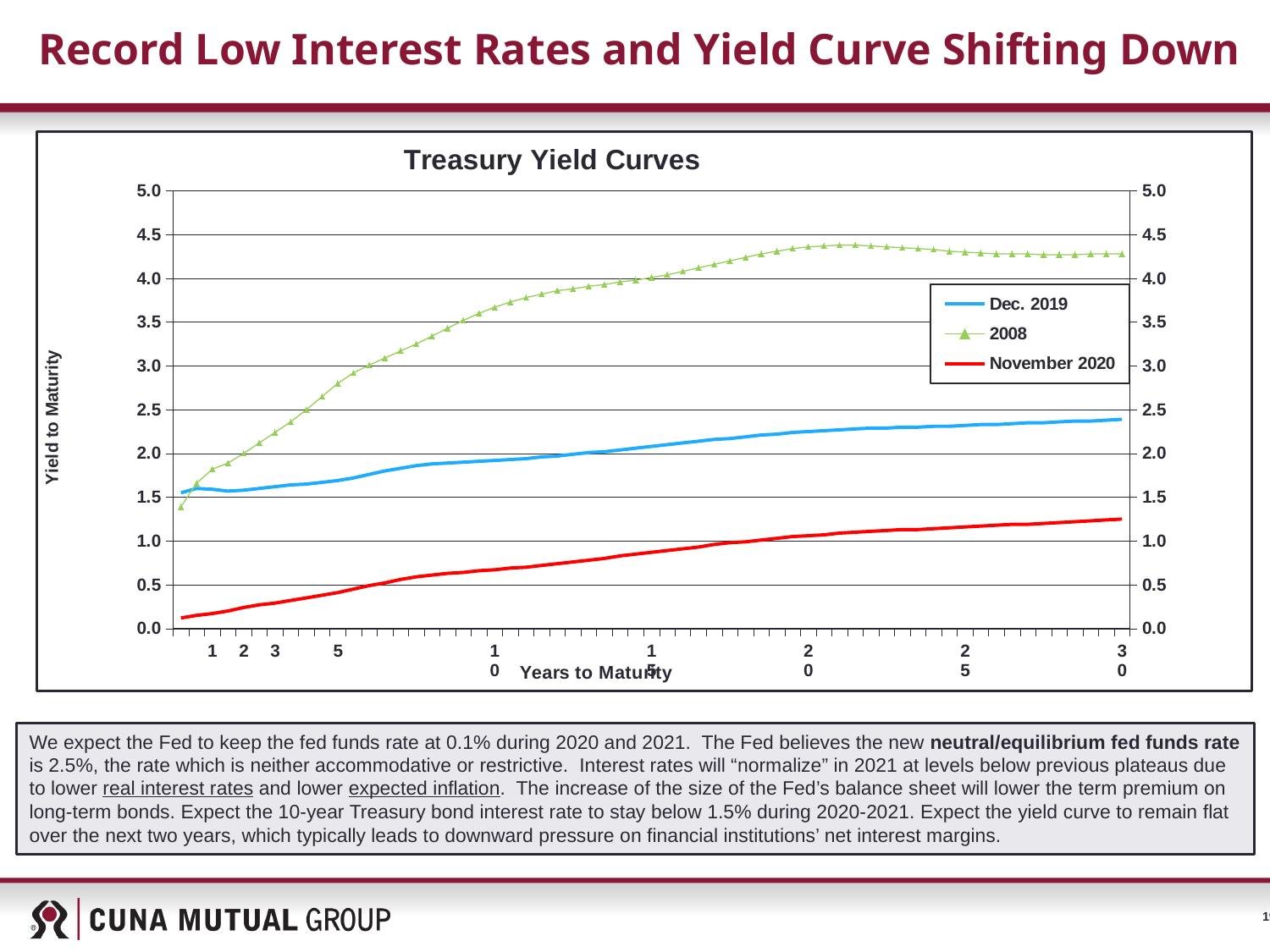
Which series has the lowest yields across the maturities shown? November 2020 Is the 2008 yield at 10 years to maturity greater or less than 3.0? greater Which series is shown in red in the chart? November 2020 Which series has the highest yields across the maturities shown? 2008 How many series does the legend of the Treasury Yield Curves chart list? 3 Is the November 2020 yield at 30 years to maturity greater or less than 1.5? less Is the Dec. 2019 yield at 30 years to maturity greater or less than 2.0? greater What is the title of the chart? Treasury Yield Curves Does the November 2020 yield curve rise or fall as years to maturity increase? rise What kind of chart is shown on the slide? line chart